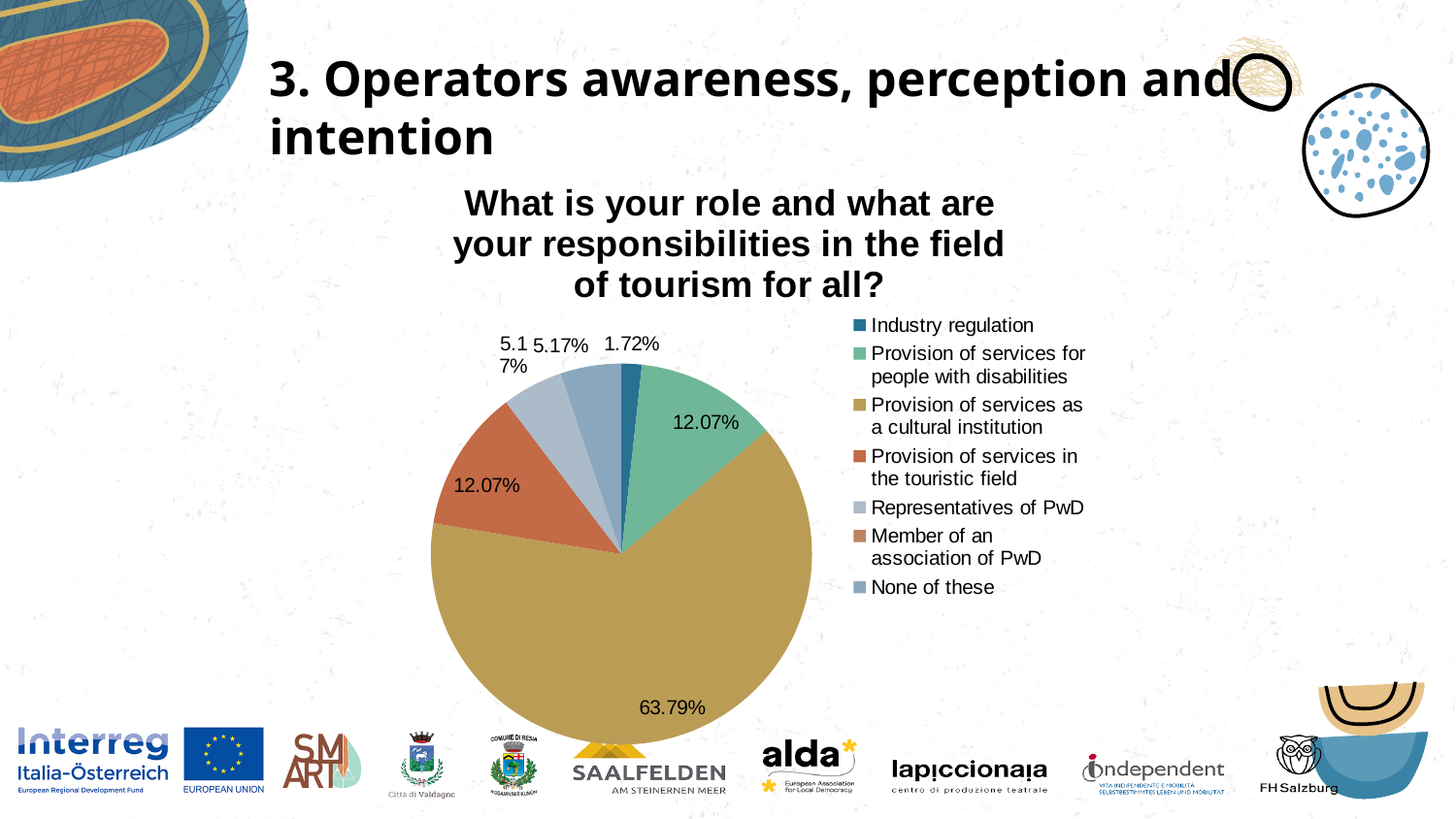
What percentage of respondents selected 'Provision of services for people with disabilities'? 12.07% What percentage of respondents selected 'Industry regulation'? 1.72% Which labelled slice has the smallest share of the pie? Industry regulation Which is larger: the share for 'Provision of services for people with disabilities' or the share for 'Industry regulation'? Provision of services for people with disabilities What is the difference in percentage points between 'Provision of services as a cultural institution' and 'Provision of services in the touristic field'? 51.72 What kind of chart is shown on the slide? pie chart What is the title of the chart? What is your role and what are your responsibilities in the field of tourism for all? What percentage of respondents selected 'Provision of services in the touristic field'? 12.07% How many entries does the legend list? 7 Which category has the largest share of the pie? Provision of services as a cultural institution What percentage of respondents selected 'Representatives of PwD'? 5.17% What percentage of respondents selected 'Provision of services as a cultural institution'? 63.79%